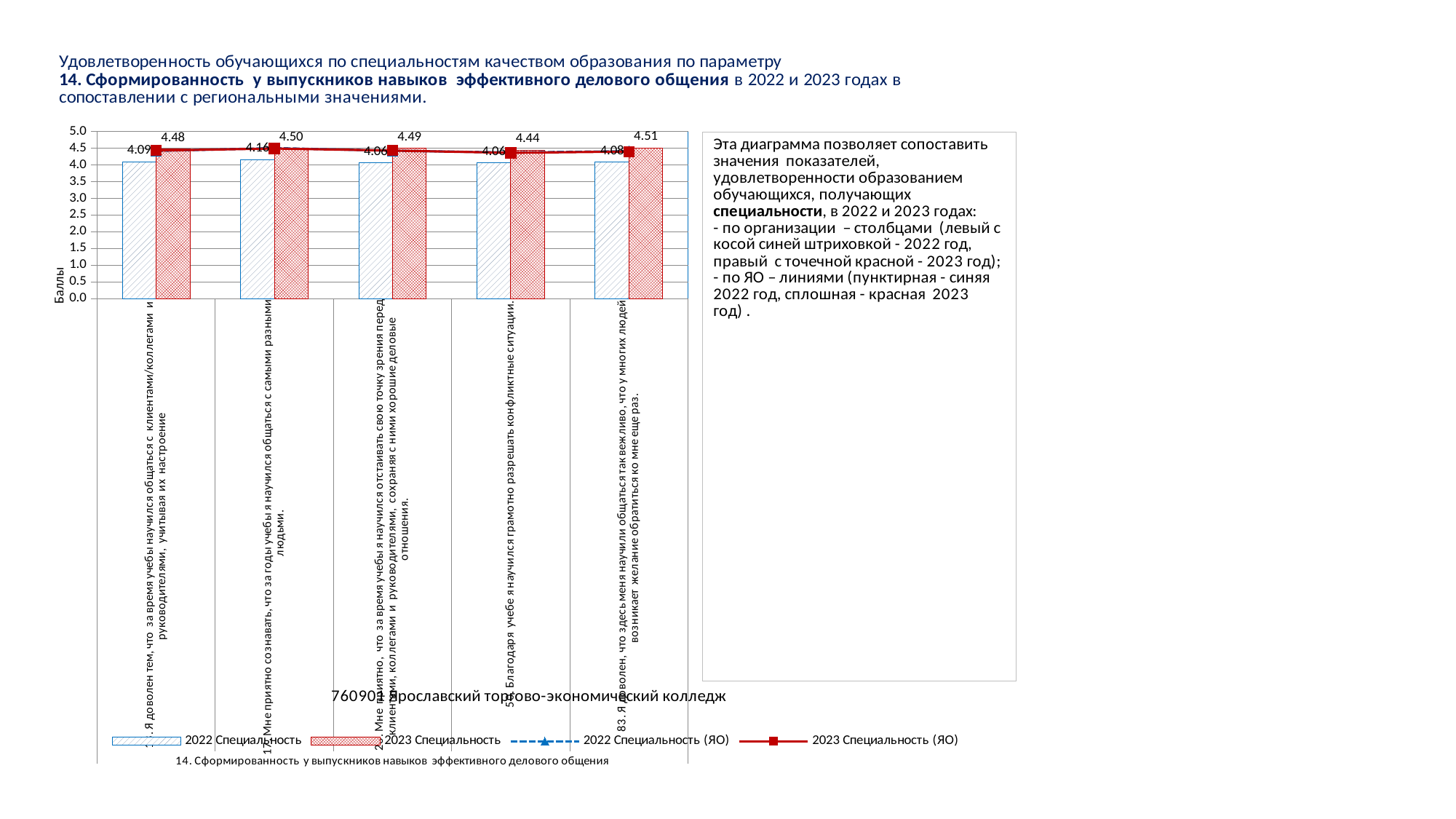
How many categories (statements) are plotted along the x axis? 5 For the first statement, which is larger: the 2022 Специальность value or the 2023 Специальность value? 2023 Специальность Which statement has the lowest 2023 Специальность value? Благодаря учебе я научился грамотно разрешать конфликтные ситуации (4.44) What is the difference between the 2023 Специальность and 2022 Специальность values for statement 17 ("Мне приятно сознавать...")? 0.34 How many series does the chart legend list? 4 What kind of chart is shown on the slide? combination bar and line chart Is the 2022 Специальность value for the first statement greater or less than 4.5? less What is the title of the vertical axis? Баллы What is the 2023 Специальность value for the statement "83. Я доволен, что здесь меня научили общаться так вежливо, что у многих людей возникает желание обратиться ко мне еще раз"? 4.51 What is the 2023 Специальность value for the statement "17. Мне приятно сознавать, что за годы учебы я научился общаться с самыми разными людьми"? 4.50 What is the 2023 Специальность value for the first statement ("1. Я доволен тем, что за время учебы научился общаться с клиентами/коллегами и руководителями...")? 4.48 Which statement has the highest 2022 Специальность value? 17. Мне приятно сознавать, что за годы учебы я научился общаться с самыми разными людьми (4.16)